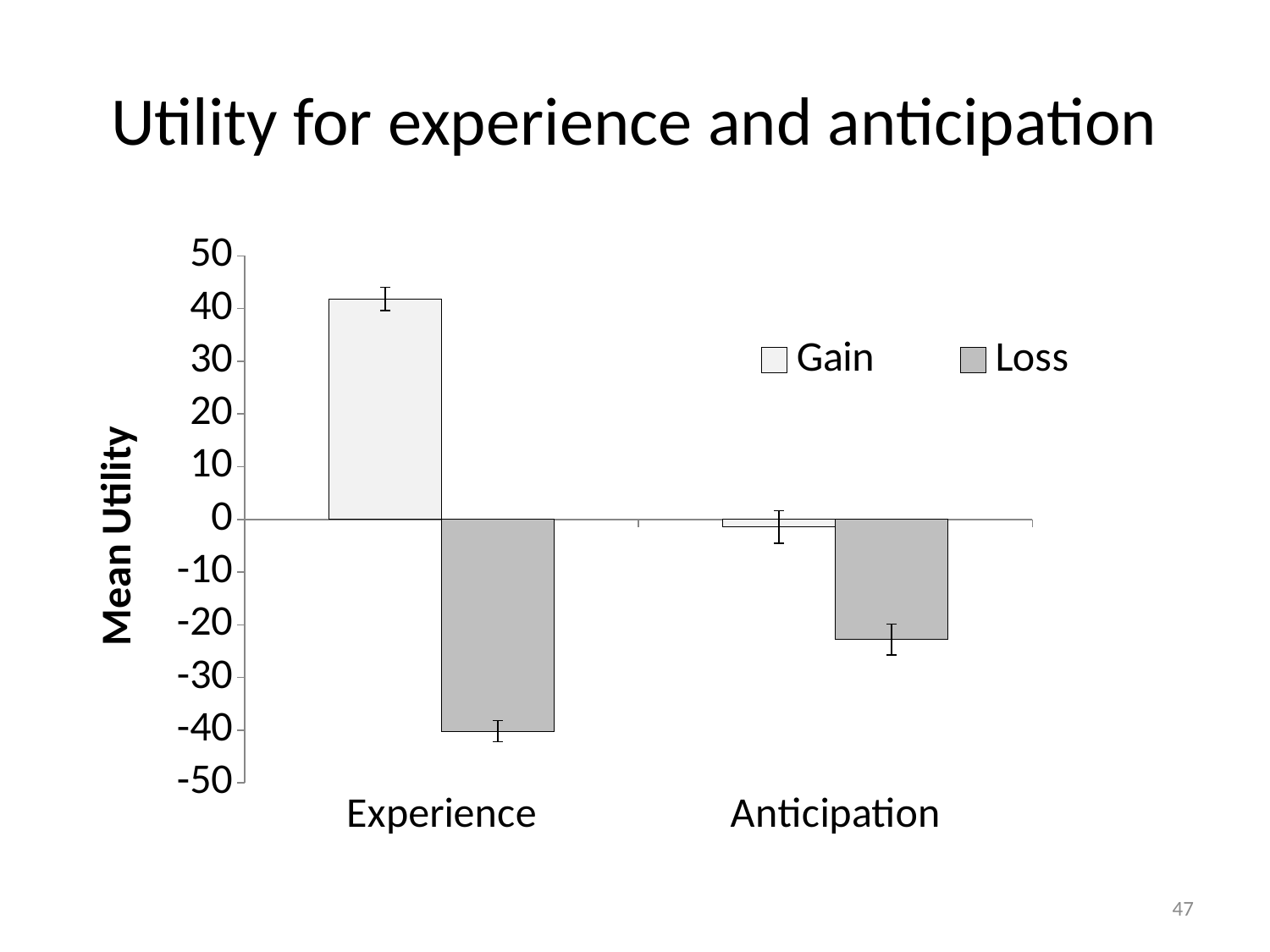
Is the Loss value for Experience greater or less than -30? less What kind of chart is shown on the slide? bar chart What is the label of the vertical axis? Mean Utility Which bar has the highest value in the chart? Gain for Experience Which category has the larger Gain value, Experience or Anticipation? Experience Is the Gain value for Experience greater or less than 30? greater Which series are listed in the chart's legend? Gain and Loss How many categories are shown on the x axis of the chart? 2 Is the Loss value for Anticipation greater or less than -10? less Which bar has the lowest value in the chart? Loss for Experience How many series does the chart's legend list? 2